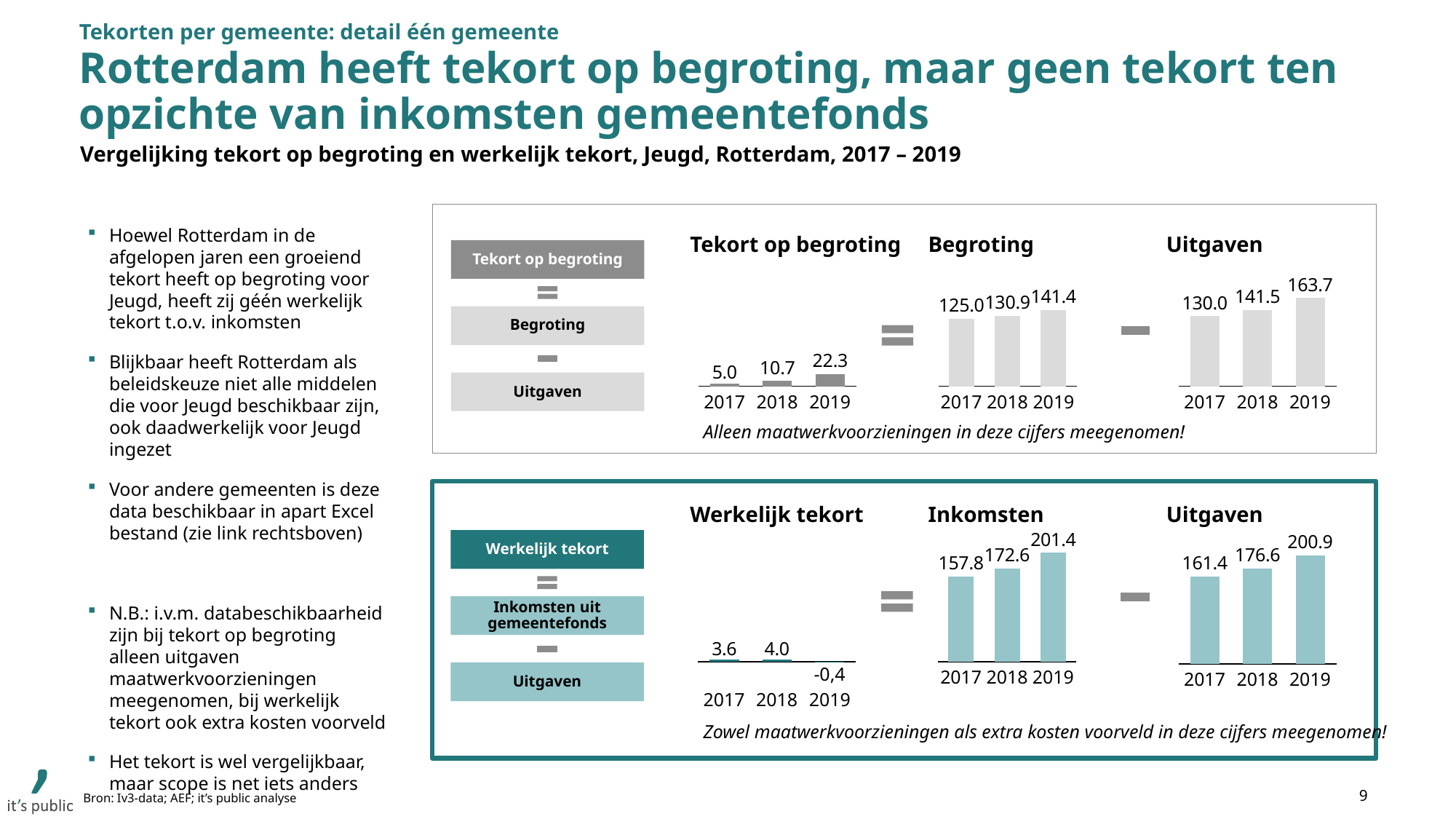
In the 'Begroting' chart, what is the value for 2017? 125.0 In the 'Tekort op begroting' chart, what is the value for 2019? 22.3 In the bottom 'Uitgaven' chart (next to 'Inkomsten'), which year has the highest value? 2019 In the top 'Uitgaven' chart (next to 'Begroting'), what is the value for 2019? 163.7 In the 'Inkomsten' chart, what is the value for 2018? 172.6 In the 'Werkelijk tekort' chart, what is the value for 2019? -0,4 What kind of chart is the 'Tekort op begroting' chart? bar chart In the 'Inkomsten' chart, what is the difference between the 2019 and 2018 values? 28.8 In the 'Tekort op begroting' chart, what is the difference between the 2019 and 2017 values? 17.3 Which is larger: the 2019 value in the 'Inkomsten' chart or the 2019 value in the bottom 'Uitgaven' chart? Inkomsten (201.4) In the 'Werkelijk tekort' chart, which year has the lowest value? 2019 In the 'Begroting' chart, do the values rise or fall from 2017 to 2019? rise